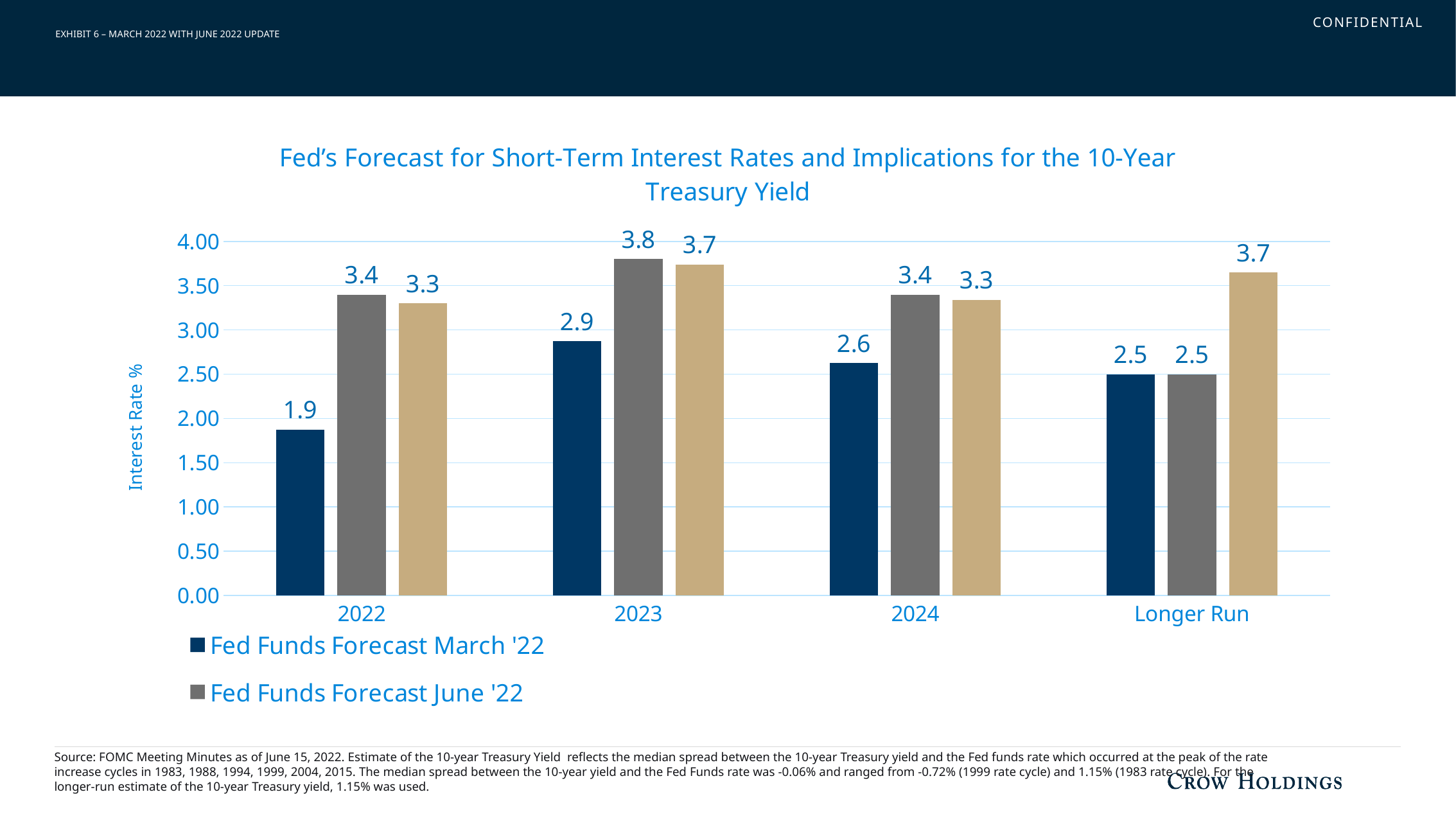
What is the Fed Funds Forecast June '22 value for Longer Run? 2.5 What kind of chart is shown on the slide? Bar chart How many series does the legend list? 2 Which category has the highest Fed Funds Forecast June '22 value? 2023 What is the Fed Funds Forecast March '22 value for 2024? 2.6 Which category has the lowest Fed Funds Forecast March '22 value? 2022 For 2024, which is larger: the Fed Funds Forecast March '22 or the Fed Funds Forecast June '22? Fed Funds Forecast June '22 What is the Fed Funds Forecast March '22 value for 2022? 1.9 What is the Fed Funds Forecast June '22 value for 2023? 3.8 How many categories are shown on the x axis? 4 For 2023, what is the difference between the Fed Funds Forecast June '22 and the Fed Funds Forecast March '22? 0.9 For 2022, how much higher is the Fed Funds Forecast June '22 than the Fed Funds Forecast March '22? 1.5